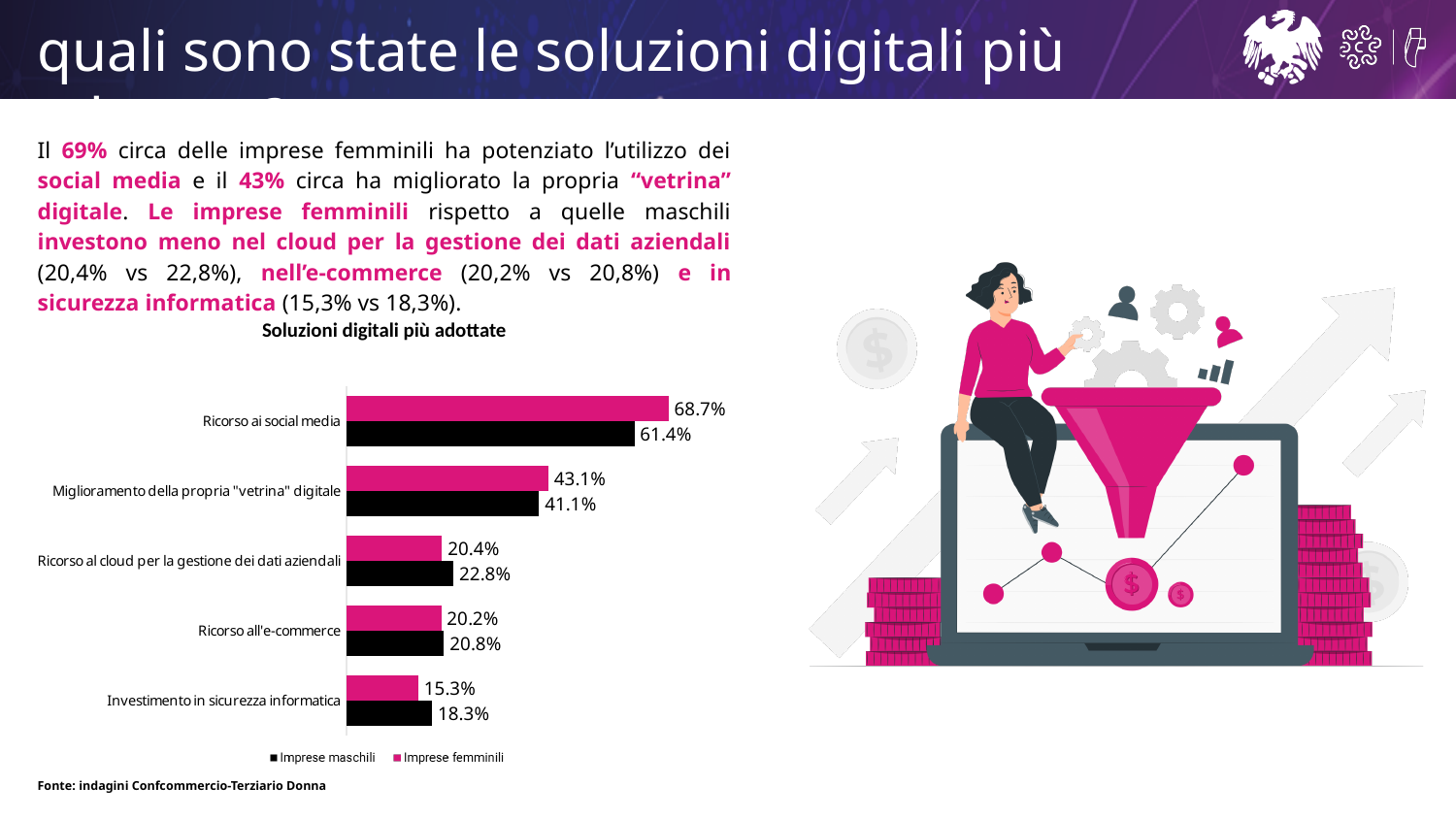
Which category has the lowest value for Imprese maschili? Investimento in sicurezza informatica What is the value for Imprese femminili in the category 'Ricorso all'e-commerce'? 20.2% What is the value for Imprese maschili in the category 'Ricorso ai social media'? 61.4% Which category has the highest value for Imprese femminili? Ricorso ai social media What is the title of the chart? Soluzioni digitali più adottate What is the difference between the Imprese femminili and Imprese maschili values for 'Ricorso al cloud per la gestione dei dati aziendali'? 2.4% In the category 'Miglioramento della propria "vetrina" digitale', which series has the larger value, Imprese maschili or Imprese femminili? Imprese femminili How many categories are shown in the chart? 5 How many series does the chart legend list? 2 What is the value for Imprese femminili in the category 'Ricorso ai social media'? 68.7% What type of chart is shown on the slide? Bar chart What is the value for Imprese maschili in the category 'Investimento in sicurezza informatica'? 18.3%